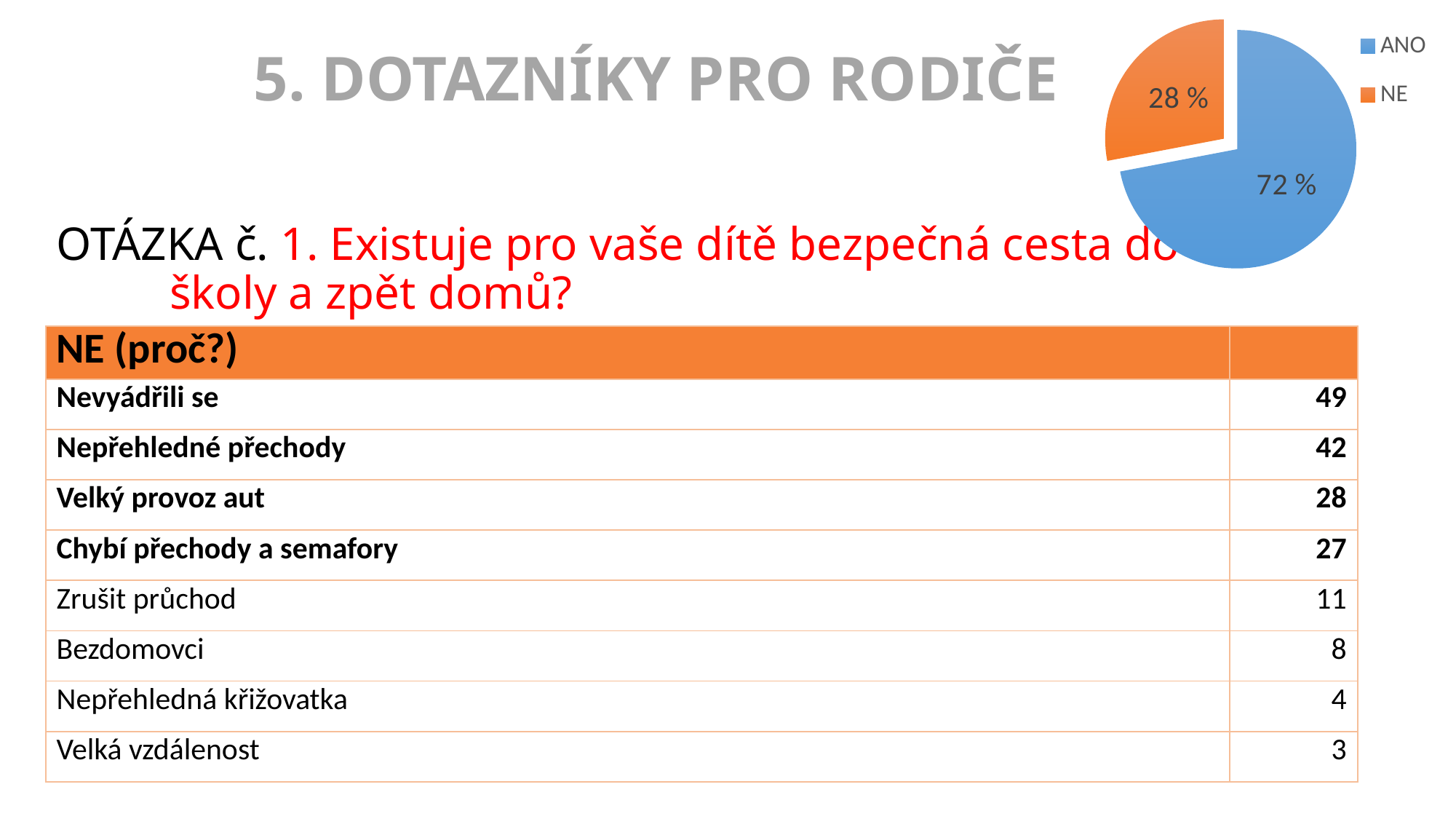
What is the difference in percentage points between the ANO and NE slices of the pie chart? 44 Which slice of the pie chart is the largest? ANO What share of the pie chart does NE represent? 28 % What share of the pie chart does ANO represent? 72 % What colour is the NE slice in the pie chart? orange Which is larger in the pie chart, ANO or NE? ANO What colour is the ANO slice in the pie chart? blue How many slices does the pie chart have? 2 Which slice of the pie chart is the smallest? NE How many entries does the pie chart legend list? 2 What kind of chart is shown in the top right of the slide? pie chart